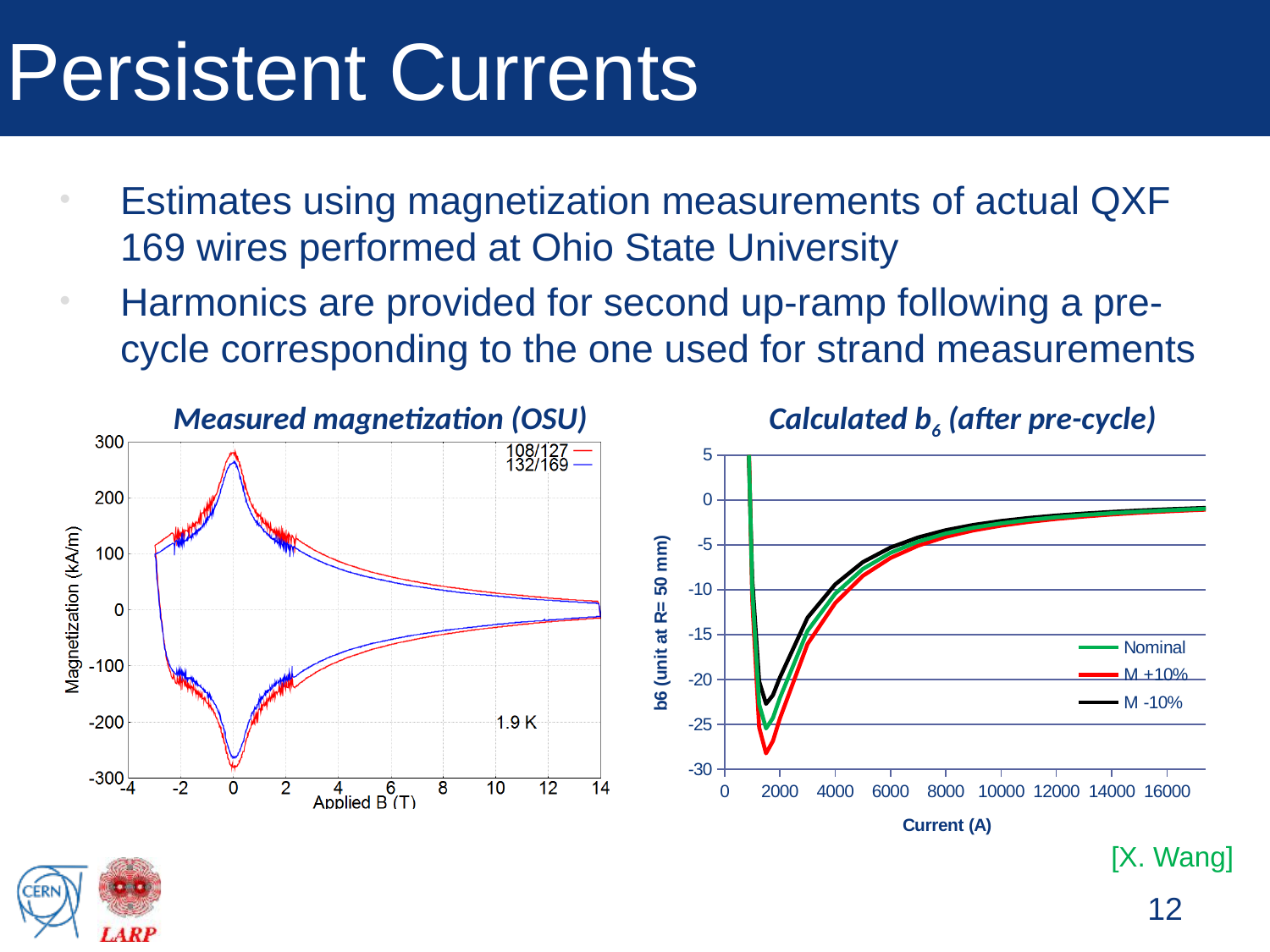
How many series does the legend of the 'Calculated b6 (after pre-cycle)' chart list? 3 How many series does the legend of the 'Measured magnetization (OSU)' chart list? 2 In the 'Calculated b6 (after pre-cycle)' chart, do the b6 values rise or fall as current increases from 2000 A to 16000 A? rise In the 'Calculated b6 (after pre-cycle)' chart, is the minimum value of the M -10% curve greater or less than -25? greater In the 'Calculated b6 (after pre-cycle)' chart, which series reaches the lowest b6 value? M +10% In the 'Measured magnetization (OSU)' chart, is the peak magnetization of the 108/127 series near 0 T greater or less than 200 kA/m? greater In the 'Calculated b6 (after pre-cycle)' chart, is the minimum value of the M +10% curve greater or less than -25? less In the 'Calculated b6 (after pre-cycle)' chart, which series is drawn in black? M -10% What kind of chart is the 'Calculated b6 (after pre-cycle)' chart on the right? line chart What is the x-axis label of the 'Calculated b6 (after pre-cycle)' chart? Current (A) In the 'Measured magnetization (OSU)' chart, which series reaches the higher peak magnetization near 0 T, 108/127 or 132/169? 108/127 What kind of chart is the 'Measured magnetization (OSU)' chart on the left? line chart